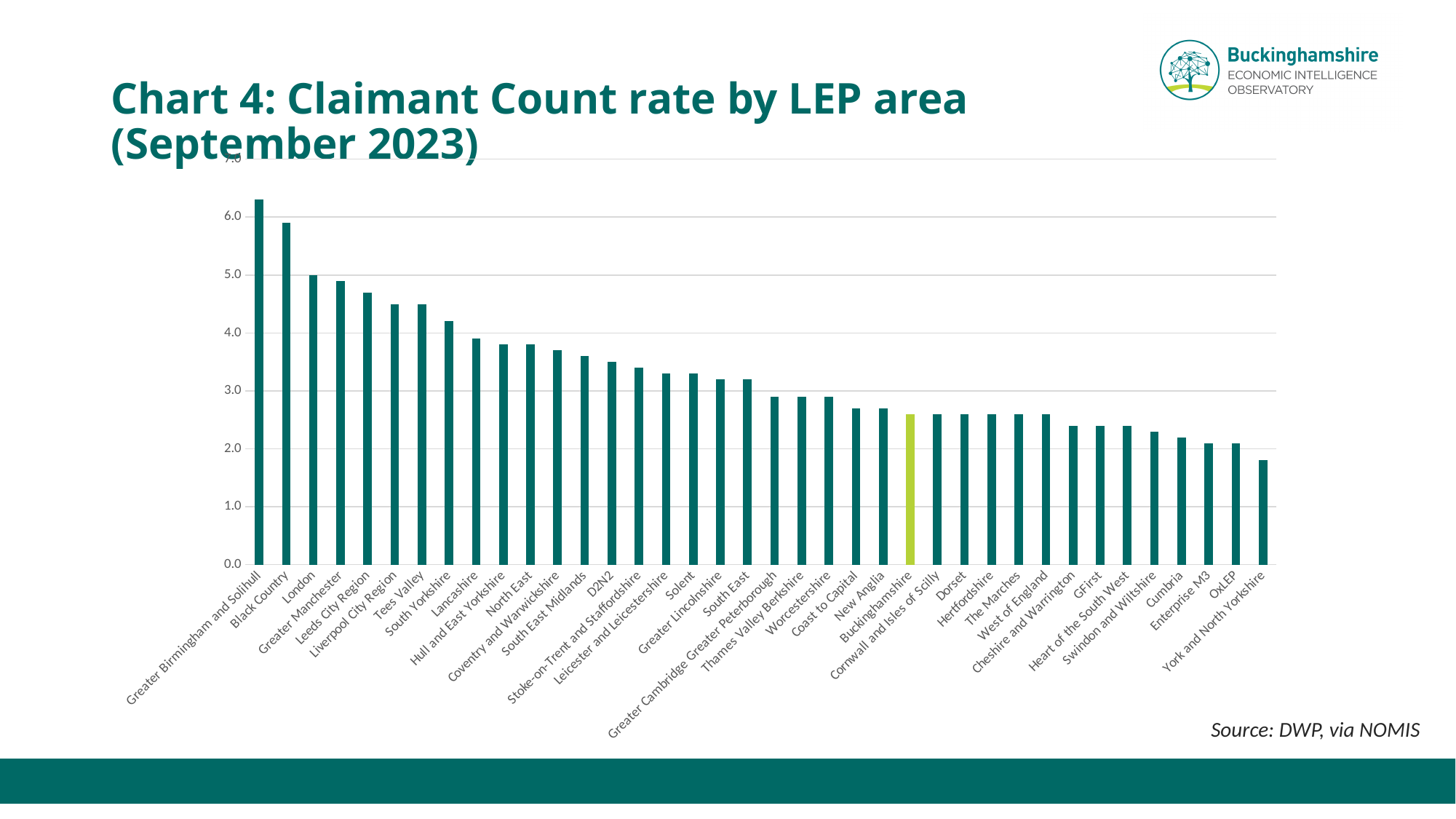
Is the value for Buckinghamshire greater or less than 3.0? less Which LEP area has the lowest claimant count rate? York and North Yorkshire Is the value for Greater Birmingham and Solihull greater or less than 6.0? greater How many LEP areas are plotted on the chart? 38 Is the value for York and North Yorkshire greater or less than 2.0? less Which LEP area has the highest claimant count rate? Greater Birmingham and Solihull What is the source cited for the chart? DWP, via NOMIS Which LEP area's bar is highlighted in a different colour from the rest? Buckinghamshire What kind of chart is shown on the slide? bar chart Do the bars rise or fall moving from left to right along the x axis? fall Which has the higher claimant count rate, London or Dorset? London